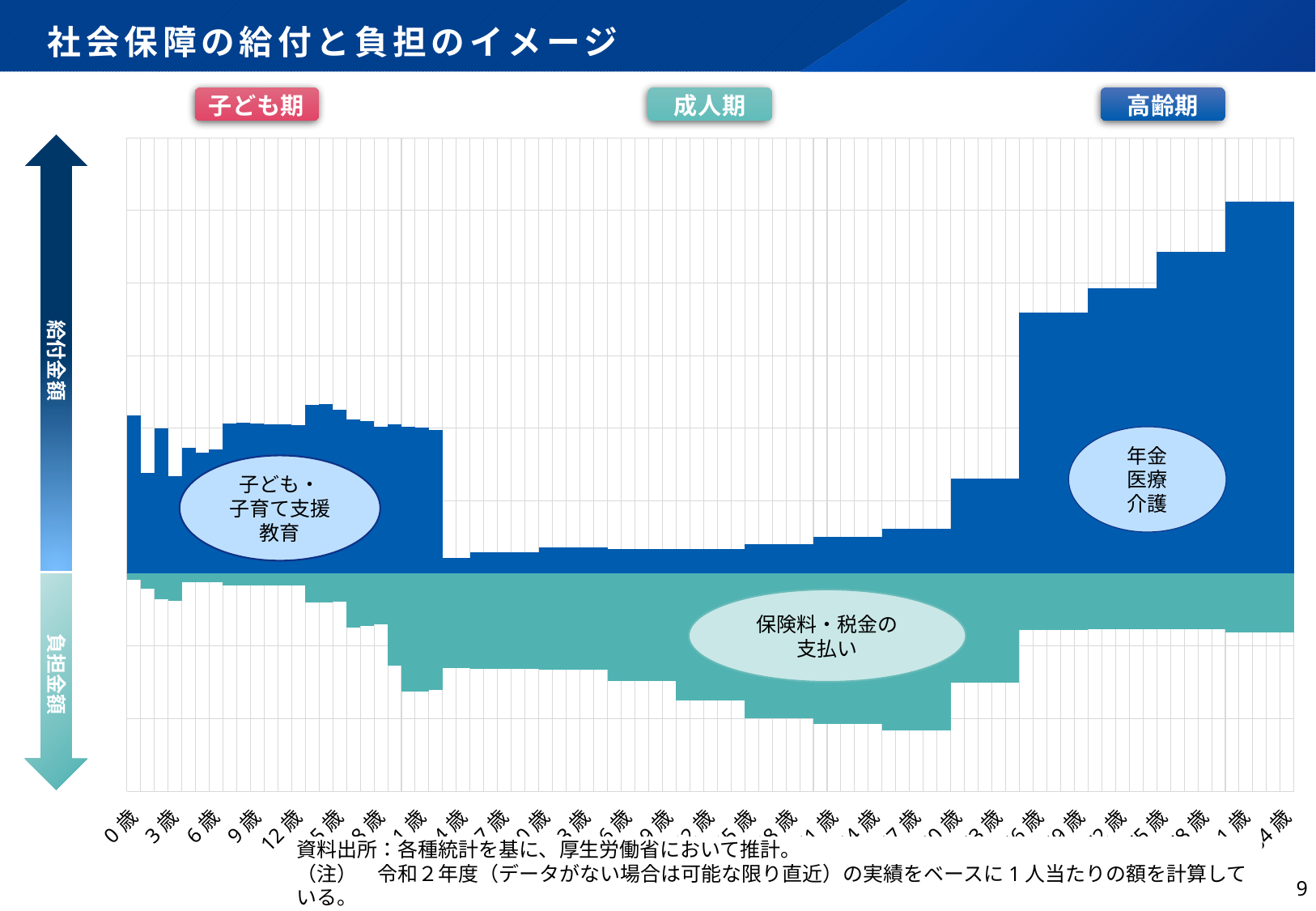
Which age group has the highest benefit amount (給付金額) in the chart? 80歳〜84歳 (all equal, the highest) Is the benefit amount (給付金額) larger at 84歳 or at 0歳? 84歳 Which life stage has the largest burden amount (負担金額)? 成人期 What does the label on the lower (teal) part of the chart say the burden consists of? 保険料・税金の支払い Is the burden amount (負担金額) larger at 57歳 or at 84歳? 57歳 What are the three life-stage labels shown above the chart? 子ども期、成人期、高齢期 What kind of chart is shown on the slide? bar chart Does the burden amount (負担金額) rise or fall from 0歳 to 21歳? rise Is the benefit amount (給付金額) larger at 0歳 or at 30歳? 0歳 Does the benefit amount (給付金額) rise or fall across the 高齢期 ages from 66歳 to 84歳? rise What is the title of the slide? 社会保障の給付と負担のイメージ